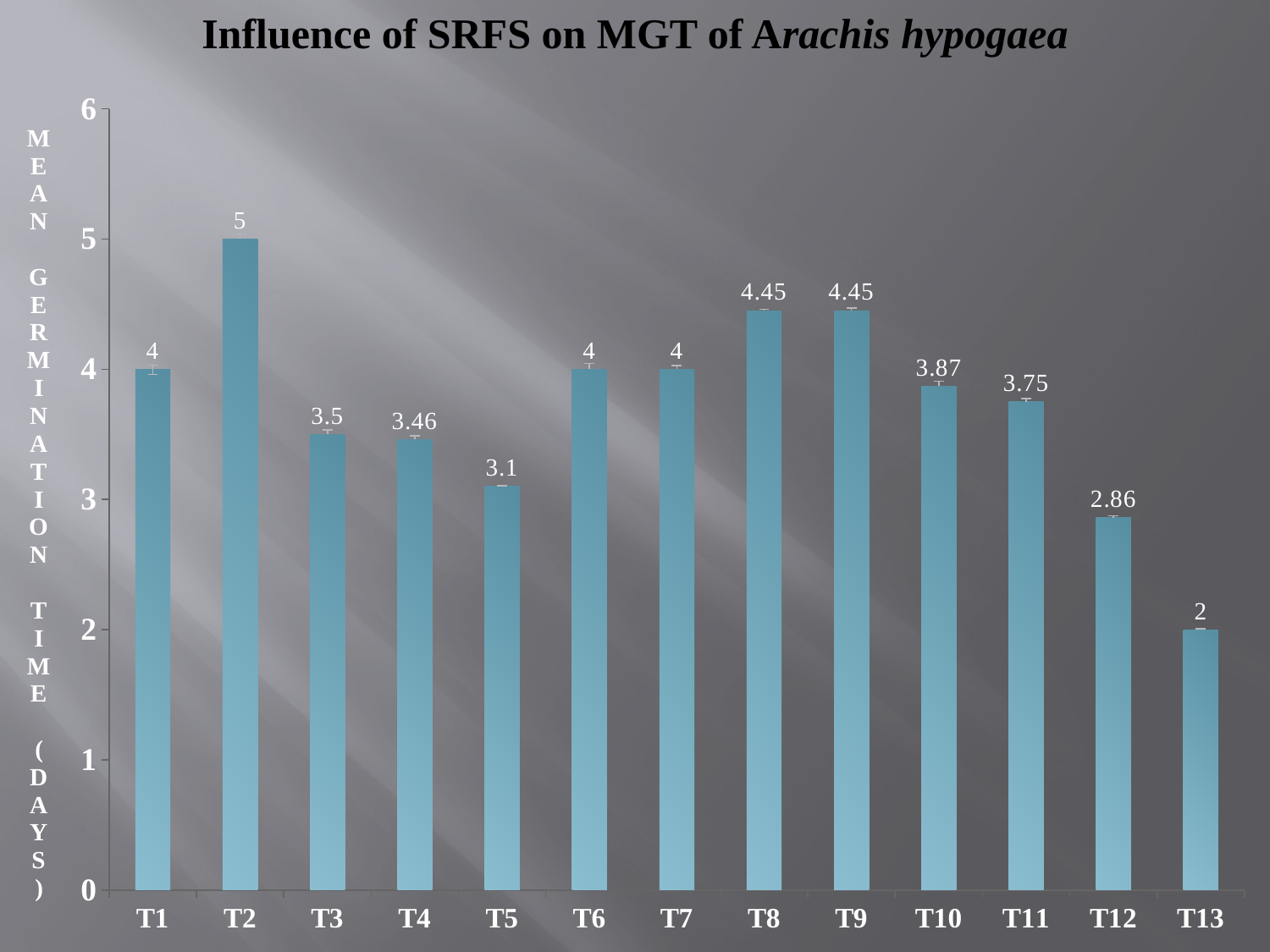
What is the difference between the values for T11 and T12? 0.89 What is the mean germination time for T2? 5 Which treatment has the highest mean germination time? T2 What is the title of the chart? Influence of SRFS on MGT of Arachis hypogaea What is the value shown for T4? 3.46 How many treatments are shown on the x axis? 13 Which has a larger value, T3 or T5? T3 Is the value for T8 greater or less than 4? greater What is the difference between the values for T2 and T13? 3 Which treatment has the lowest mean germination time? T13 What kind of chart is shown on the slide? Bar chart What is the value shown for T10? 3.87